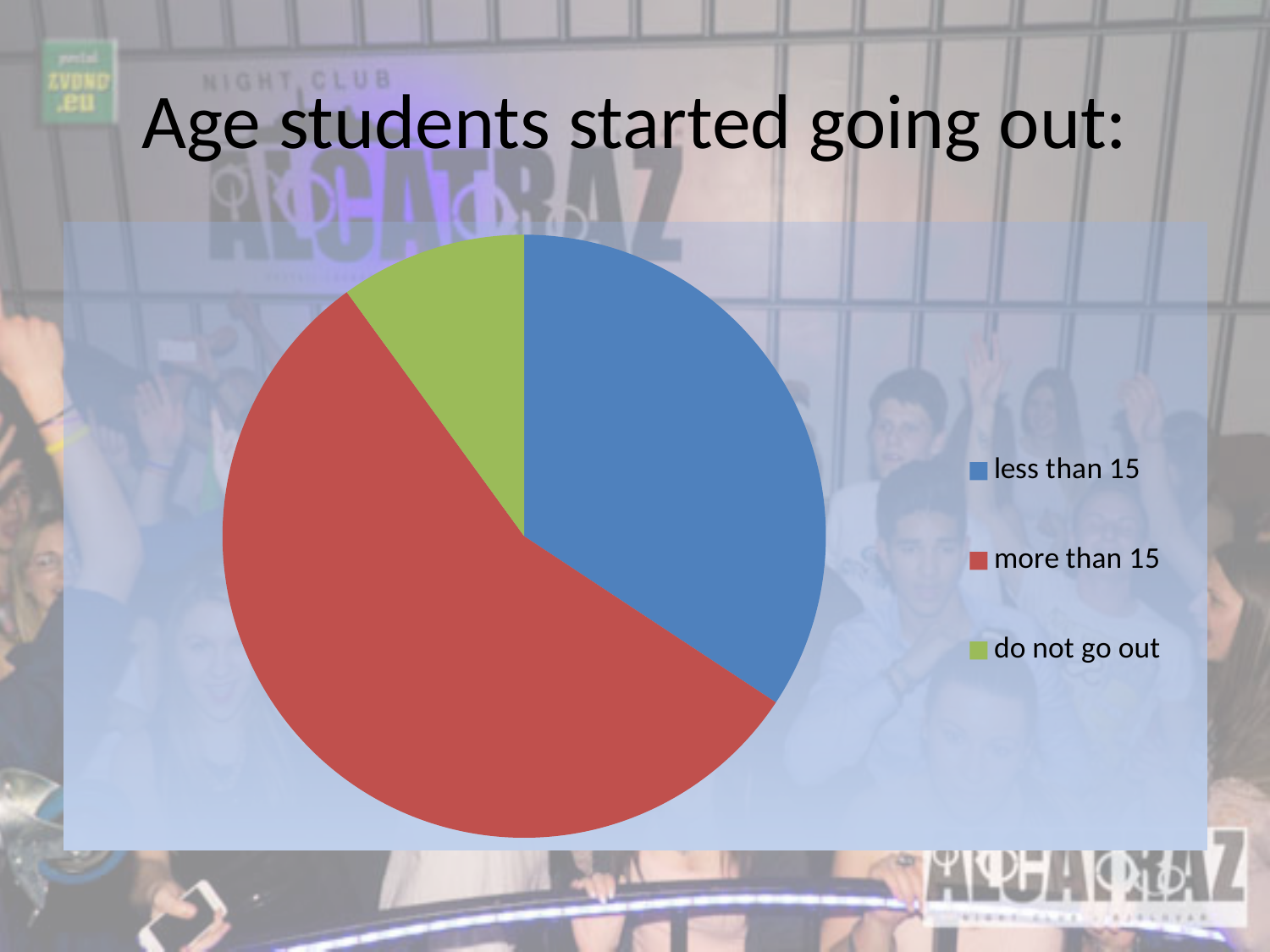
How many slices does the pie chart have? 3 Which slice is larger: "less than 15" or "do not go out"? less than 15 What colour is the "do not go out" slice? green Which slice is larger: "less than 15" or "more than 15"? more than 15 How many entries does the legend list? 3 Which category has the smallest slice of the pie? do not go out What is the title of the chart? Age students started going out: Which slice is smaller: "more than 15" or "do not go out"? do not go out What kind of chart is shown on the slide? pie chart Which category has the largest slice of the pie? more than 15